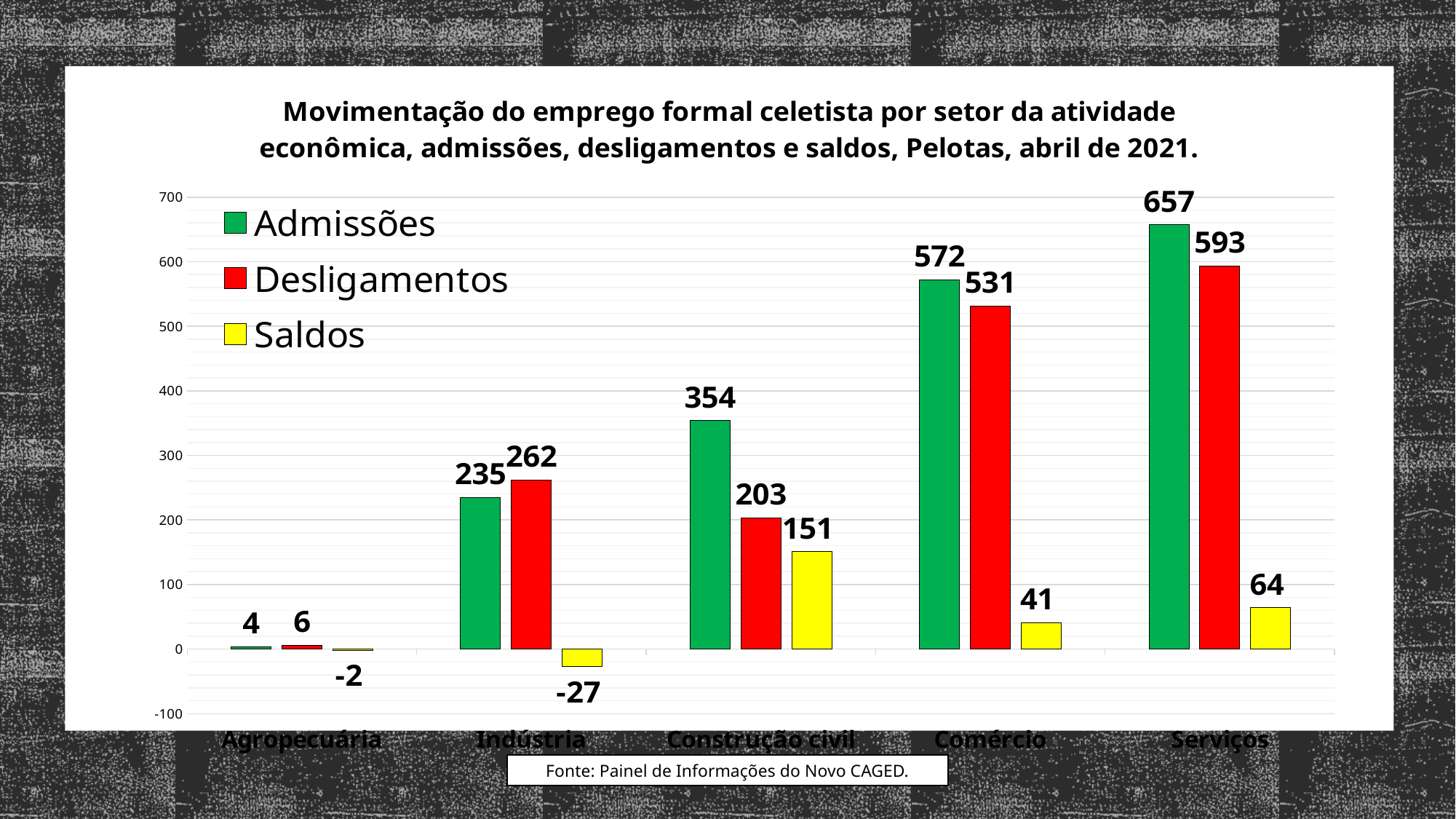
Which sector has the lowest value for Saldos? Indústria What colour are the Saldos bars? Yellow Which is larger for Indústria, Admissões or Desligamentos? Desligamentos What is the difference between Admissões and Desligamentos for Comércio? 41 What is the value of Saldos for Construção civil? 151 How many sectors are shown on the x axis? 5 What kind of chart is shown on the slide? Bar chart What is the value of Saldos for Indústria? -27 Which sector has the highest value for Admissões? Serviços What is the value of Admissões for Serviços? 657 How many series does the legend list? 3 What is the value of Desligamentos for Indústria? 262